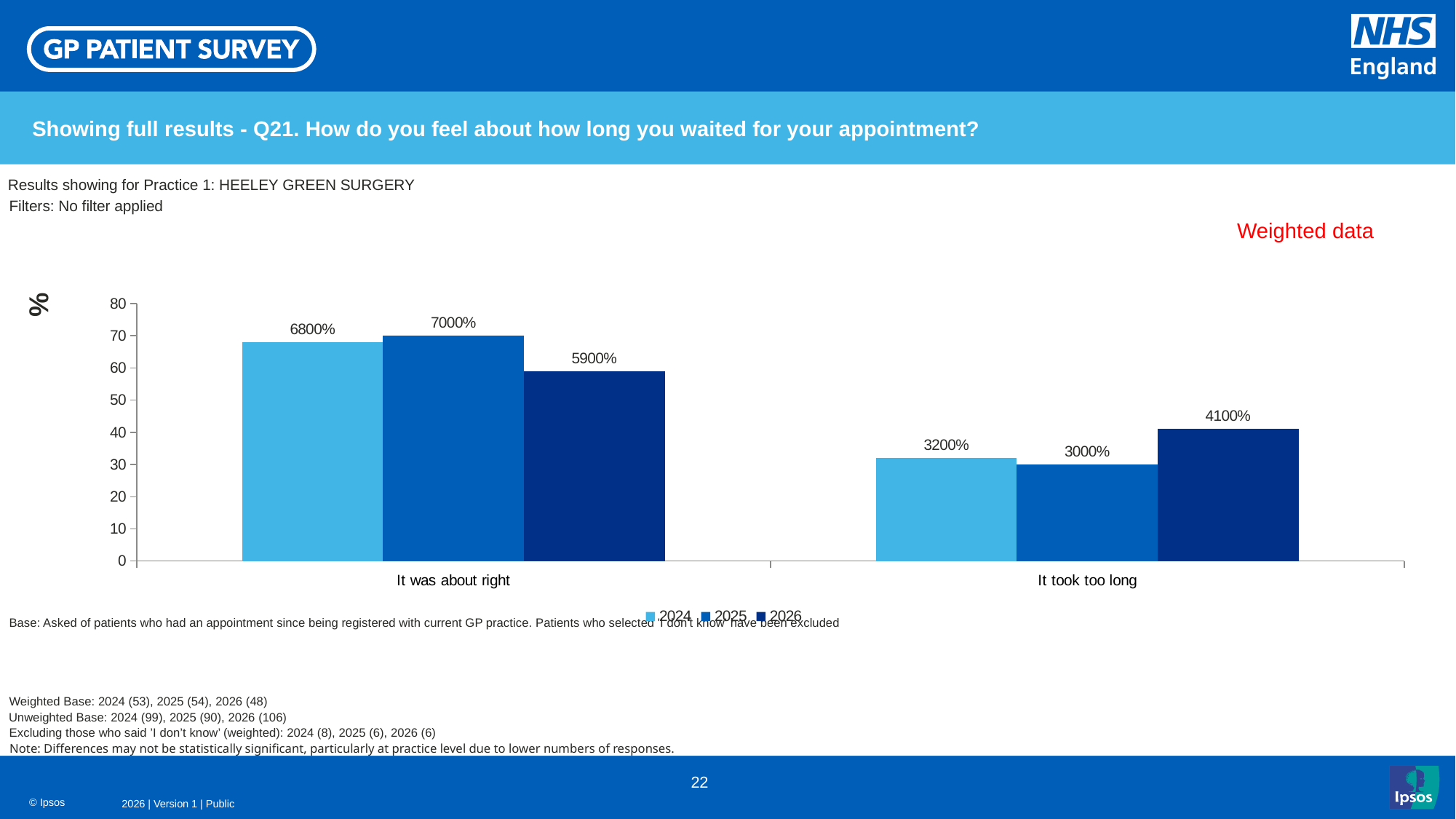
What is the data label for 2026 in the 'It took too long' category? 4100% What kind of chart is shown on the slide? Bar chart Which year has the highest value in the 'It was about right' category? 2025 How many categories are shown on the x axis? 2 Which year has the lowest value in the 'It took too long' category? 2025 Which is larger in the 'It took too long' category: the 2024 bar or the 2026 bar? 2026 What is the data label for 2025 in the 'It was about right' category? 7000% How many series does the legend list? 3 What is the data label for 2024 in the 'It was about right' category? 6800% Which practice are the results shown for? HEELEY GREEN SURGERY Is the 2024 bar for 'It took too long' greater or less than 30 on the axis? greater